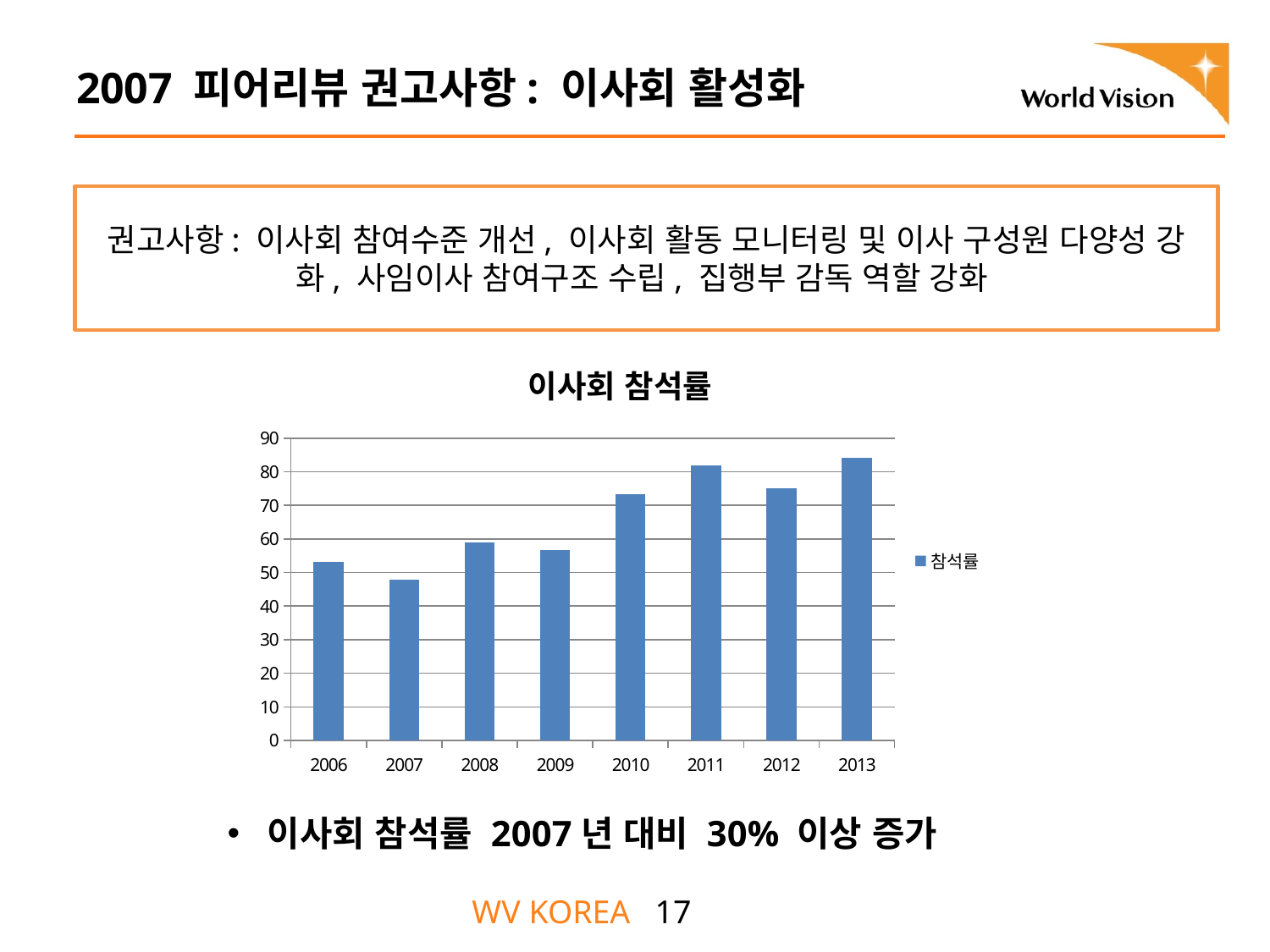
Which is larger, the value for 2006 or the value for 2010? 2010 Is the value for 2007 greater or less than 50? less What kind of chart is shown under the title 이사회 참석률? bar chart Which is larger, the value for 2011 or the value for 2012? 2011 Overall, do the values in the 이사회 참석률 chart rise or fall from 2006 to 2013? rise Which year has the lowest value in the 이사회 참석률 chart? 2007 How many years are shown on the x axis of the 이사회 참석률 chart? 8 Is the value for 2013 greater or less than 80? greater Is the value for 2010 greater or less than 70? greater How many series does the legend of the 이사회 참석률 chart list? 1 What is the legend entry of the 이사회 참석률 chart? 참석률